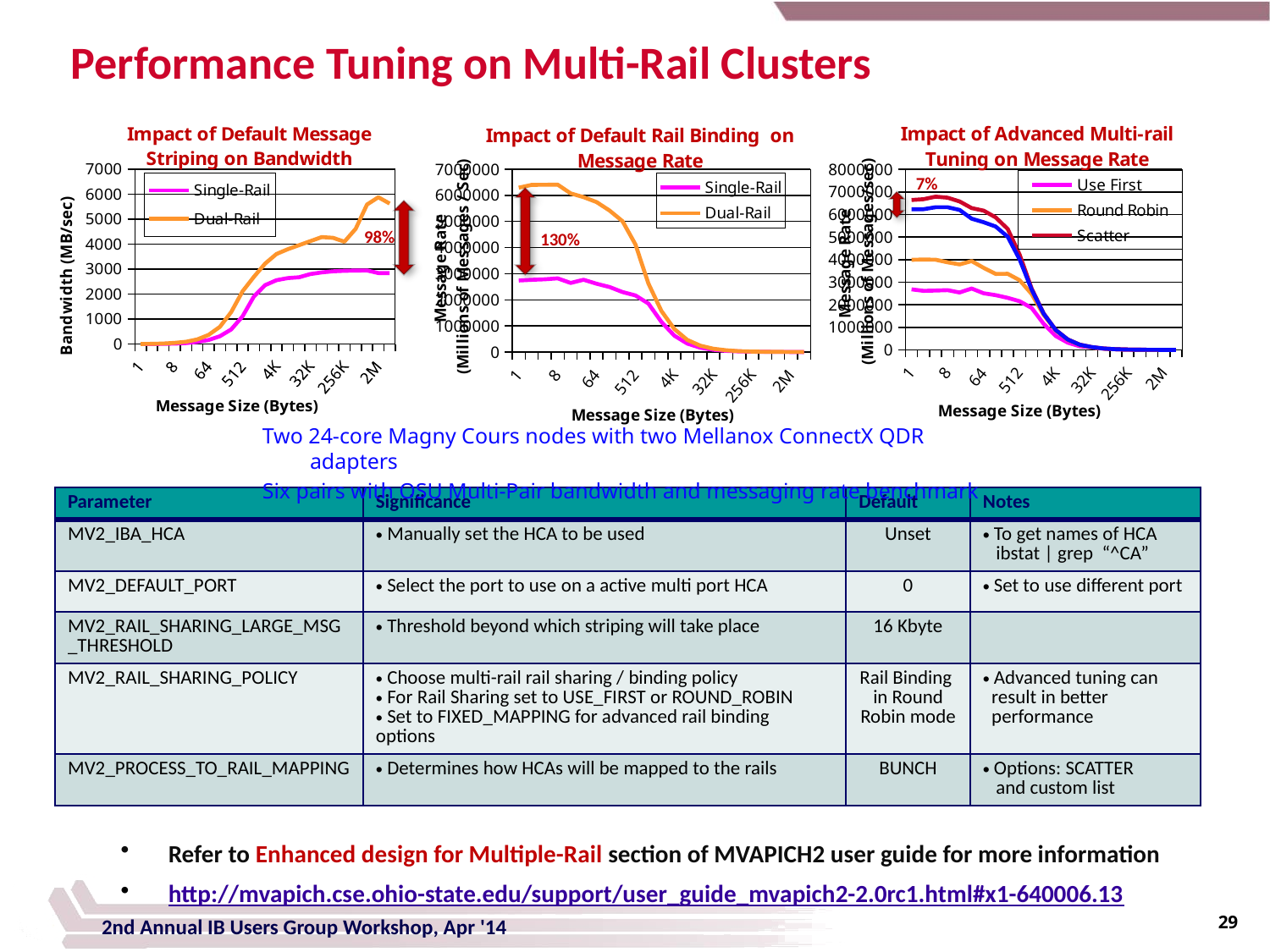
In 'Impact of Default Rail Binding on Message Rate', what percentage improvement is annotated on the chart? 130% In 'Impact of Default Rail Binding on Message Rate', does the Dual-Rail message rate rise or fall as message size increases? fall In 'Impact of Advanced Multi-rail Tuning on Message Rate', which has the higher message rate at message size 64: Scatter or Use First? Scatter In 'Impact of Advanced Multi-rail Tuning on Message Rate', is the Use First message rate at message size 1 greater or less than 3000000? less In 'Impact of Default Message Striping on Bandwidth', is the Single-Rail bandwidth at message size 2M greater or less than 4000? less In 'Impact of Default Message Striping on Bandwidth', what percentage improvement is annotated on the chart? 98% How many series does the legend of 'Impact of Advanced Multi-rail Tuning on Message Rate' list? 3 In 'Impact of Default Rail Binding on Message Rate', is the Dual-Rail message rate at message size 8 greater or less than 6000000? greater In 'Impact of Default Message Striping on Bandwidth', does bandwidth generally rise or fall as message size increases? rise How many series does the legend of 'Impact of Default Rail Binding on Message Rate' list? 2 What kind of chart is 'Impact of Default Message Striping on Bandwidth'? Line chart